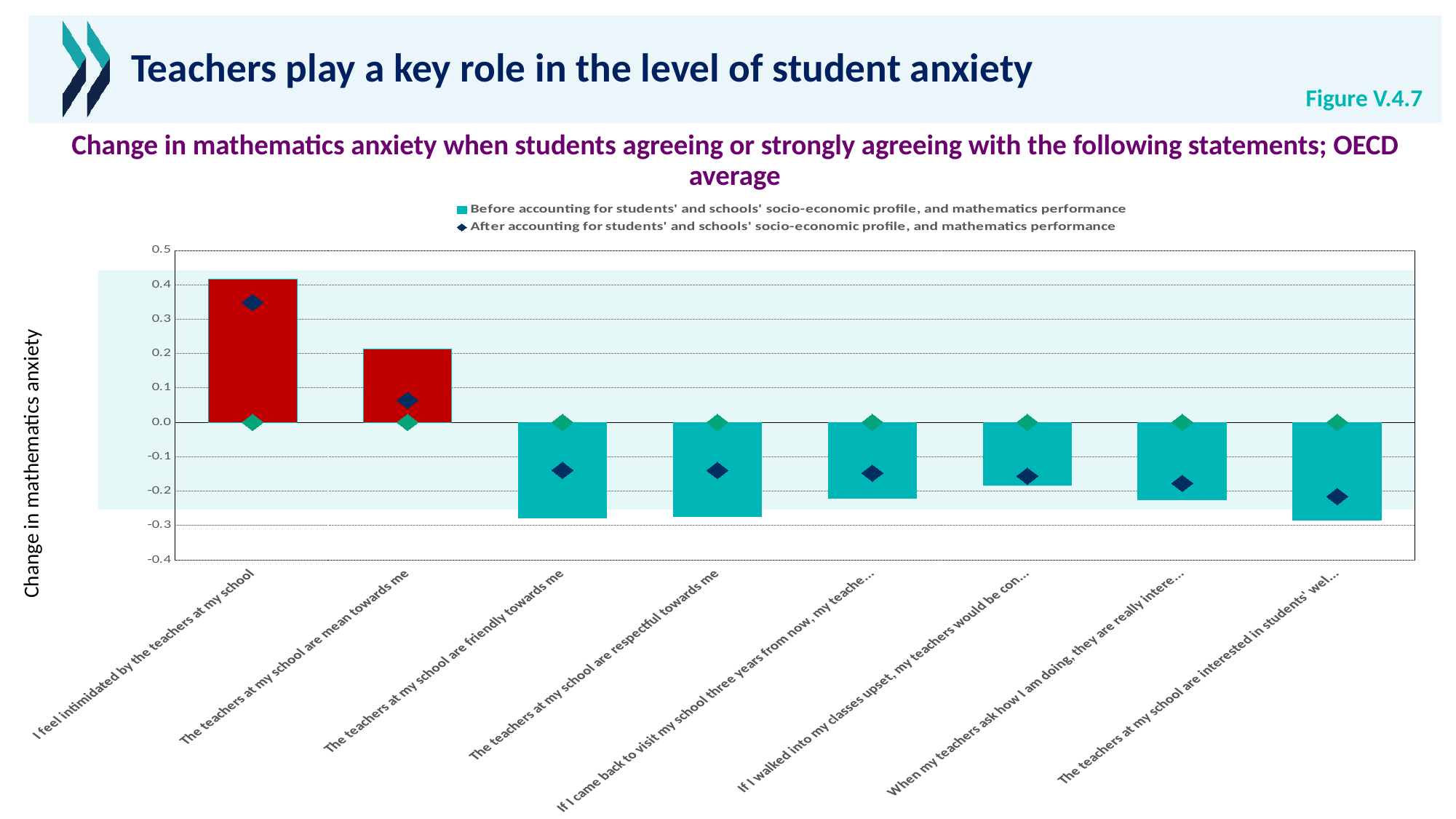
Is the 'before accounting' bar for 'The teachers at my school are friendly towards me' greater or less than -0.2? less How many series does the legend list? 2 What figure number is shown on the slide? Figure V.4.7 Which has the larger 'before accounting' value: 'I feel intimidated by the teachers at my school' or 'The teachers at my school are mean towards me'? I feel intimidated by the teachers at my school Which statement has the highest change in mathematics anxiety before accounting for socio-economic profile and mathematics performance? I feel intimidated by the teachers at my school Is the 'before accounting' bar for 'The teachers at my school are mean towards me' greater or less than 0.1? greater Is the 'before accounting' bar for 'I feel intimidated by the teachers at my school' greater or less than 0.3? greater What kind of chart is shown on the slide? bar chart How many statements (categories) are plotted along the x axis? 8 What is the label of the vertical axis? Change in mathematics anxiety Which has the larger 'before accounting' value: 'The teachers at my school are mean towards me' or 'The teachers at my school are respectful towards me'? The teachers at my school are mean towards me